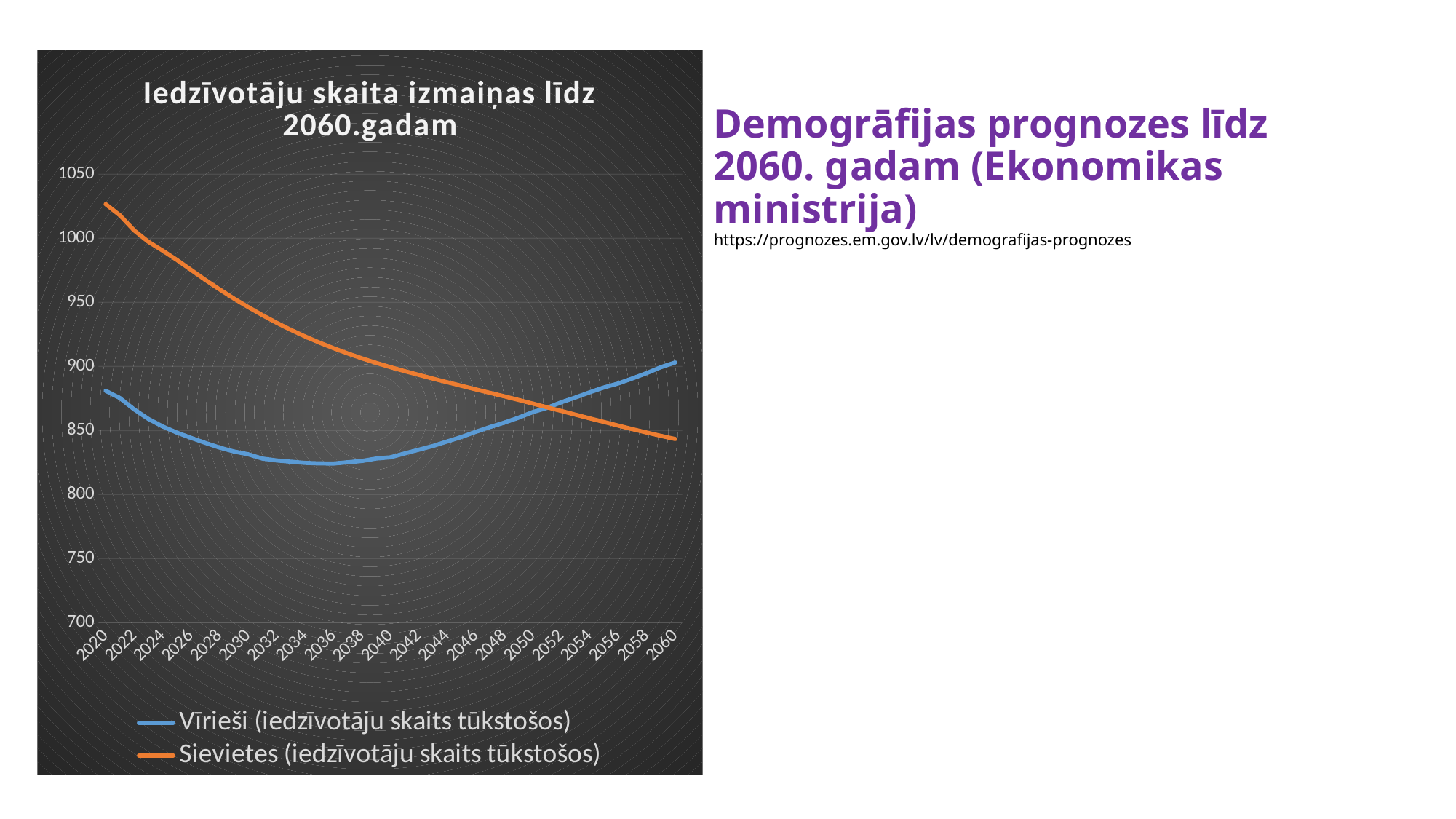
What is the title of the chart? Iedzīvotāju skaita izmaiņas līdz 2060.gadam What kind of chart is shown on the slide? line chart Is the value for Vīrieši in 2060 greater or less than 850? greater How many year labels are shown on the x axis? 21 How many series does the legend list? 2 Is the value for Vīrieši in 2020 greater or less than 900? less Is the value for Sievietes in 2060 greater or less than 900? less In 2060, which series has the higher value, Vīrieši or Sievietes? Vīrieši In 2020, which series has the higher value, Vīrieši or Sievietes? Sievietes Does the Sievietes (iedzīvotāju skaits tūkstošos) line rise or fall from 2020 to 2060? fall Which colour is used for the Sievietes (iedzīvotāju skaits tūkstošos) series? orange